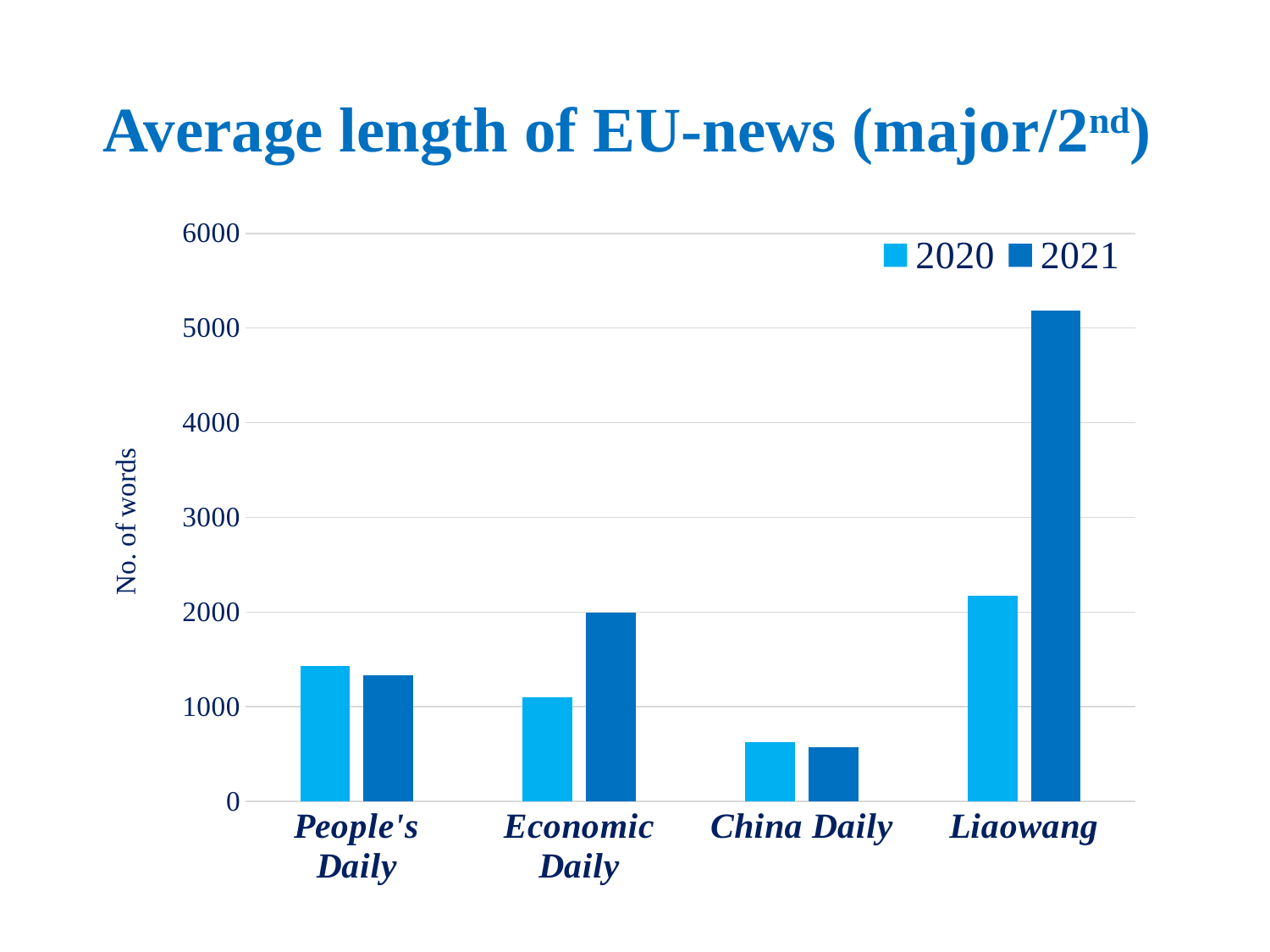
What is the label of the y axis? No. of words Is the 2021 value for China Daily greater or less than 1000? less Which newspaper has the lowest value for 2020? China Daily What kind of chart is shown on the slide? bar chart Which newspaper has the highest value for 2020? Liaowang What is the title of the chart? Average length of EU-news (major/2nd) Is the 2020 value for Economic Daily greater or less than 1000? greater Which newspaper has the highest value for 2021? Liaowang For Economic Daily, which is larger: the 2020 value or the 2021 value? 2021 How many newspapers are shown on the x axis? 4 Is the 2021 value for Liaowang greater or less than 5000? greater How many series does the legend list? 2